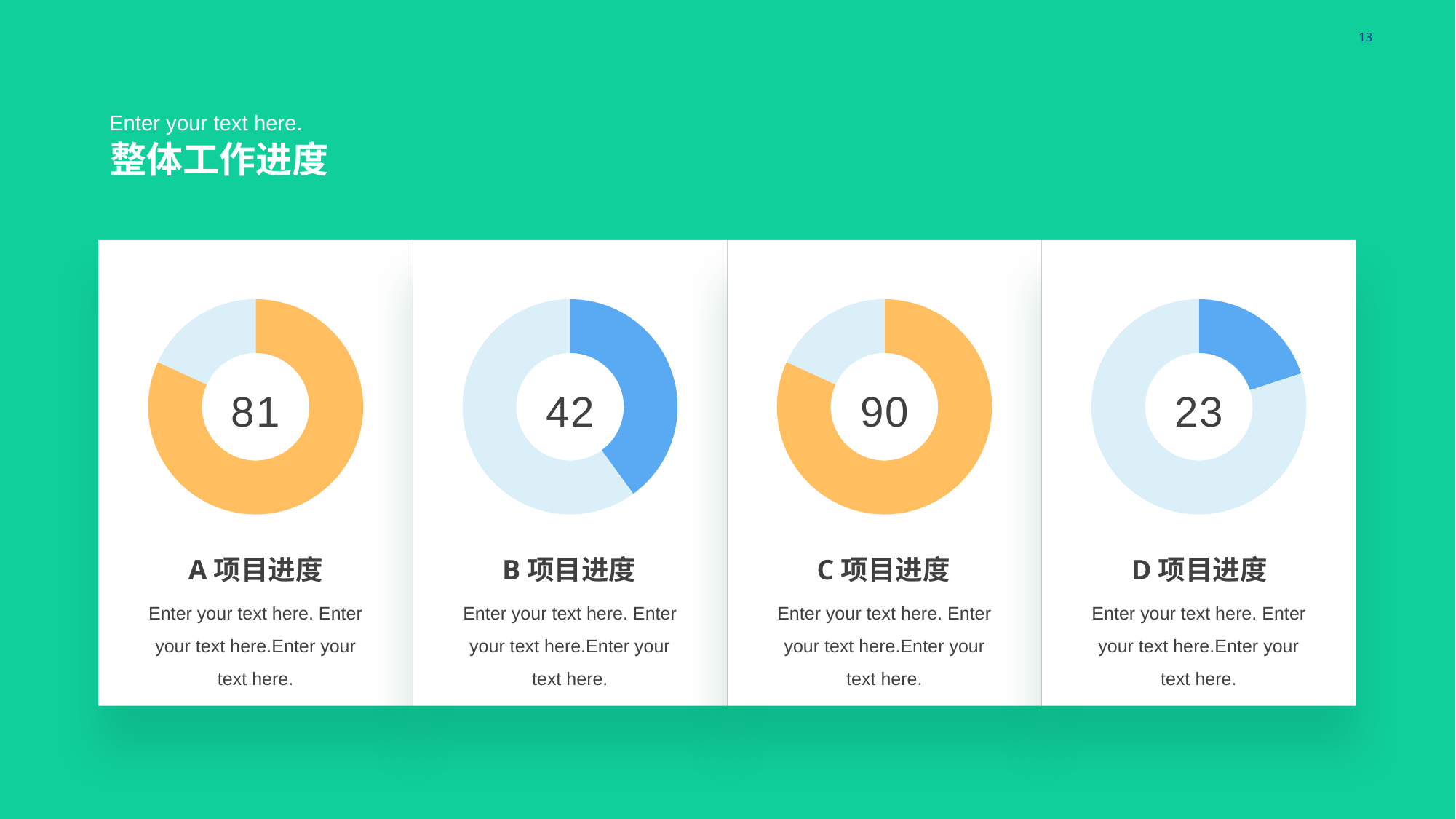
What colour is the filled portion of the B 项目进度 donut chart? Blue What value is shown in the centre of the A 项目进度 donut chart? 81 How many donut charts are shown on the slide? 4 What is the difference between the values shown for A 项目进度 and B 项目进度? 39 What value is shown in the centre of the B 项目进度 donut chart? 42 What is the difference between the values shown for C 项目进度 and D 项目进度? 67 Which is larger, the value for A 项目进度 or the value for B 项目进度? A 项目进度 Which project's donut chart shows the highest value? C 项目进度 What value is shown in the centre of the D 项目进度 donut chart? 23 Which project's donut chart shows the lowest value? D 项目进度 What kind of chart is used for each project's progress on this slide? Donut chart What value is shown in the centre of the C 项目进度 donut chart? 90